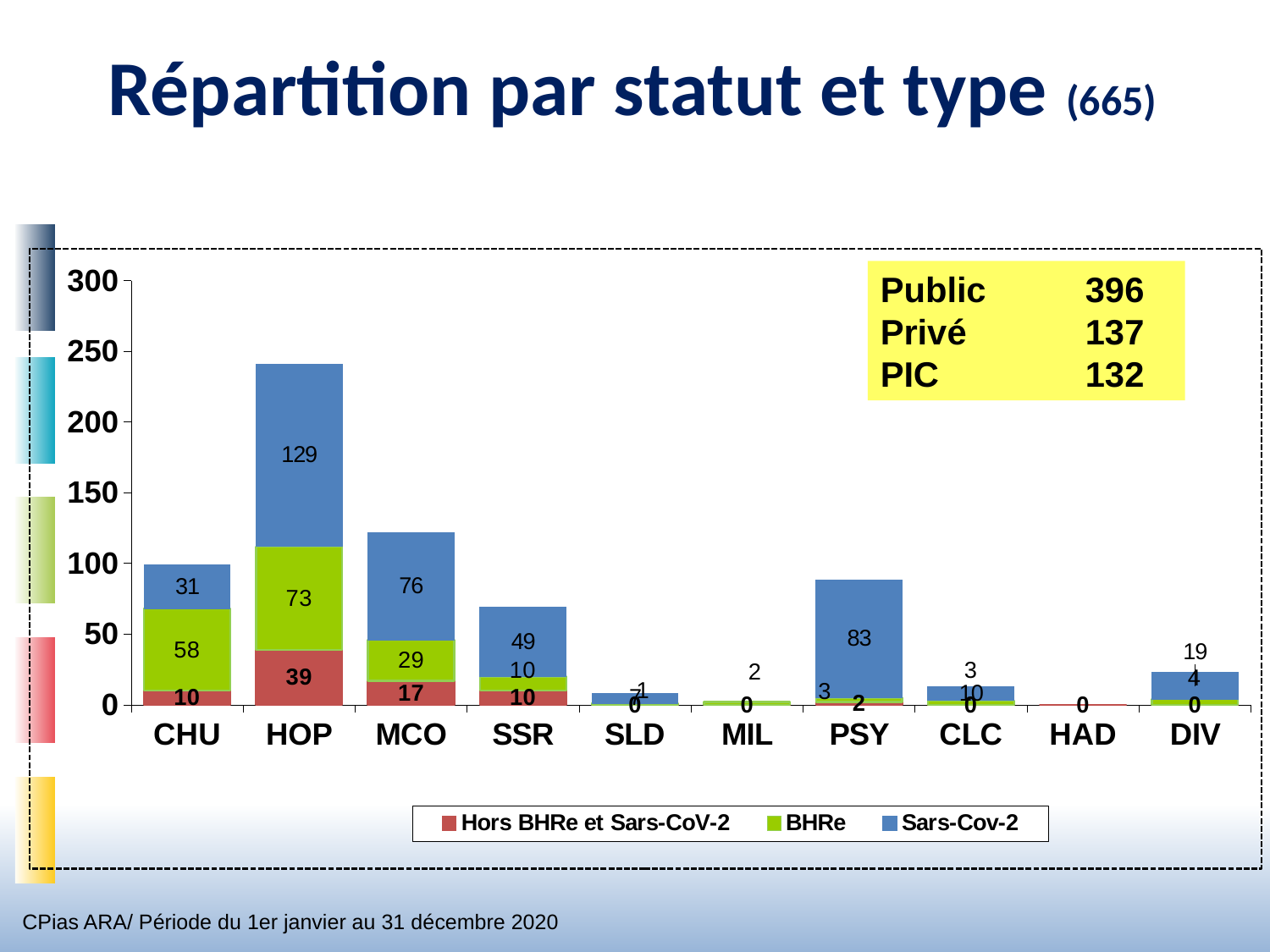
Which category has the tallest stacked bar? HOP What is the Hors BHRe et Sars-CoV-2 value for MCO? 17 What is the total of the stacked bar for HOP? 241 What is the difference between the Sars-Cov-2 values for HOP and MCO? 53 Is the total stacked bar for HOP greater or less than 200? greater How many series does the legend list? 3 What is the Sars-Cov-2 value for PSY? 83 What is the Sars-Cov-2 value for HOP? 129 What type of chart is shown on the slide? stacked bar chart What is the BHRe value for CHU? 58 How many categories are shown on the x axis? 10 What is the total of the stacked bar for CHU? 99